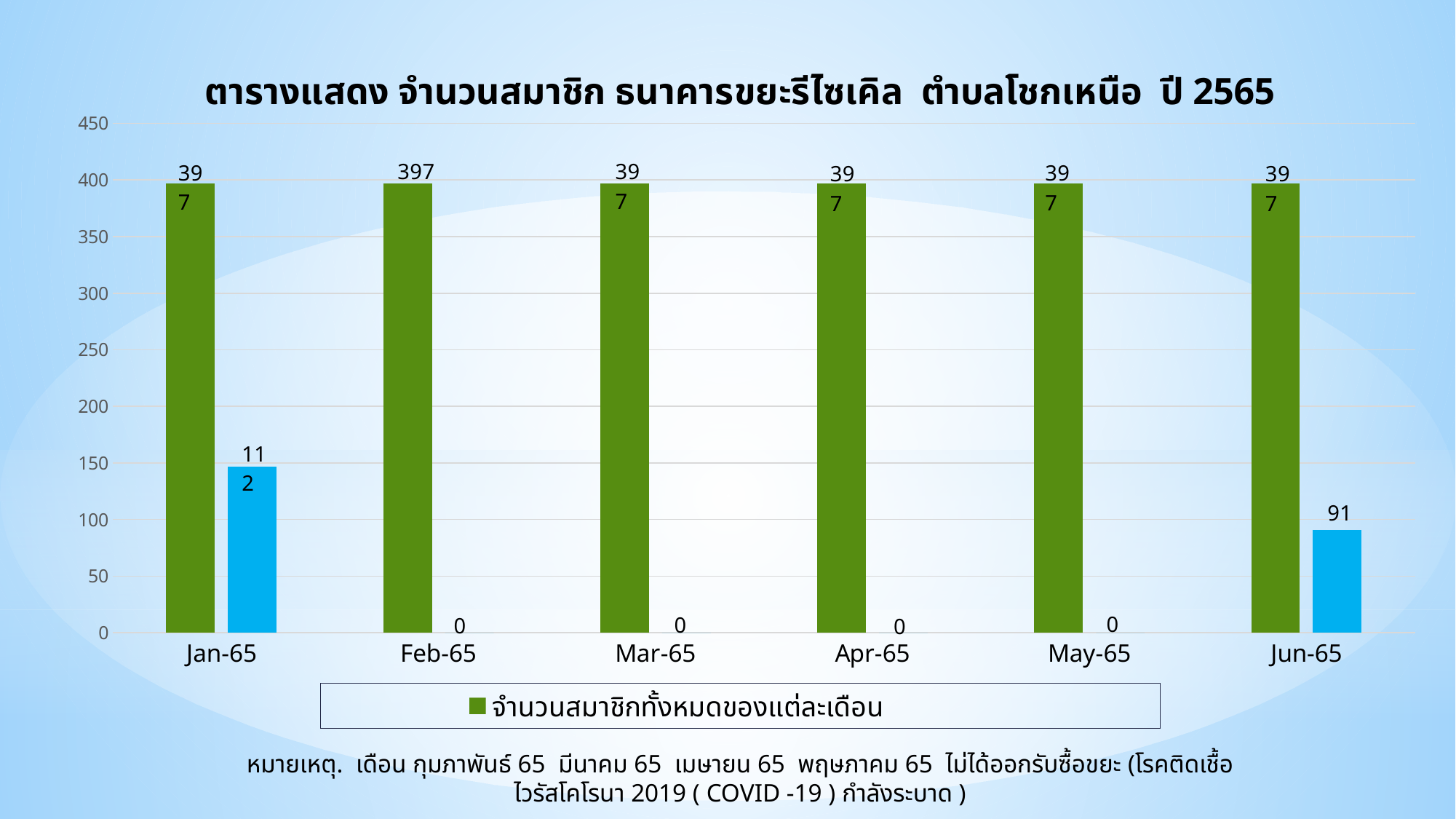
What is the legend entry shown for the green bars? จำนวนสมาชิกทั้งหมดของแต่ละเดือน What type of chart is shown on the slide? bar chart Which month has the highest value for the blue bars? Jan-65 Which is larger for Jun-65, the green bar or the blue bar? the green bar What is the value of the green bar for Jan-65? 397 What is the value of the blue bar for Mar-65? 0 How many months are shown on the x axis of the chart? 6 What is the value of the green bar for Feb-65? 397 How many series does the chart legend list? 1 What is the value of the blue bar for Jun-65? 91